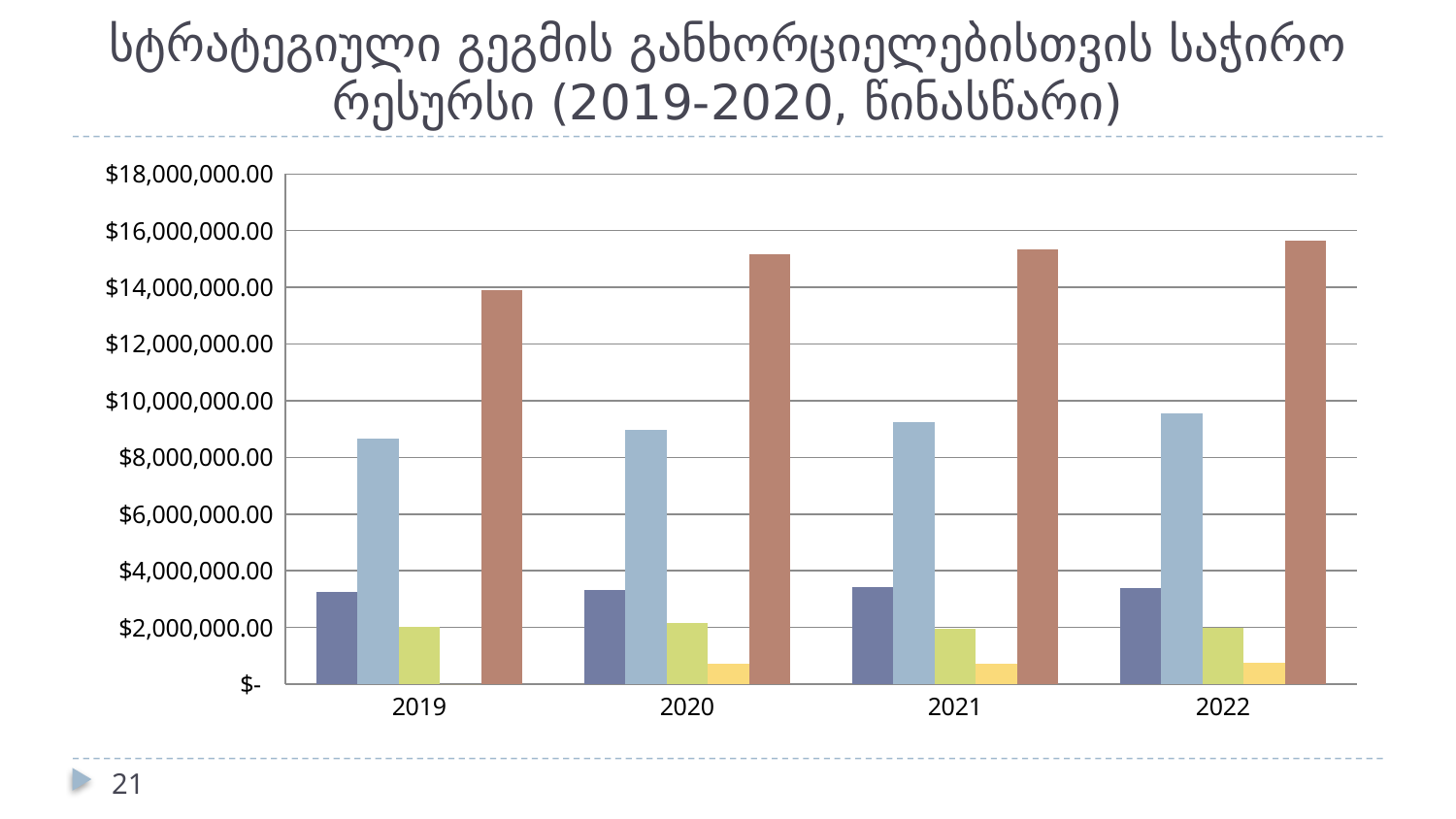
What kind of chart is shown on the slide? bar chart Do the brown bars rise or fall from 2019 to 2022? rise Is the brown bar for 2020 greater or less than $14,000,000.00? greater Which year has the highest brown bar? 2022 Which year range is given in parentheses in the chart title? 2019-2020 Is the light blue bar for 2022 greater or less than $10,000,000.00? less Which is larger, the light blue bar for 2022 or the light blue bar for 2019? 2022 How many year categories are shown on the x axis? 4 Is the light blue bar for 2019 greater or less than $8,000,000.00? greater Which year has the lowest brown bar? 2019